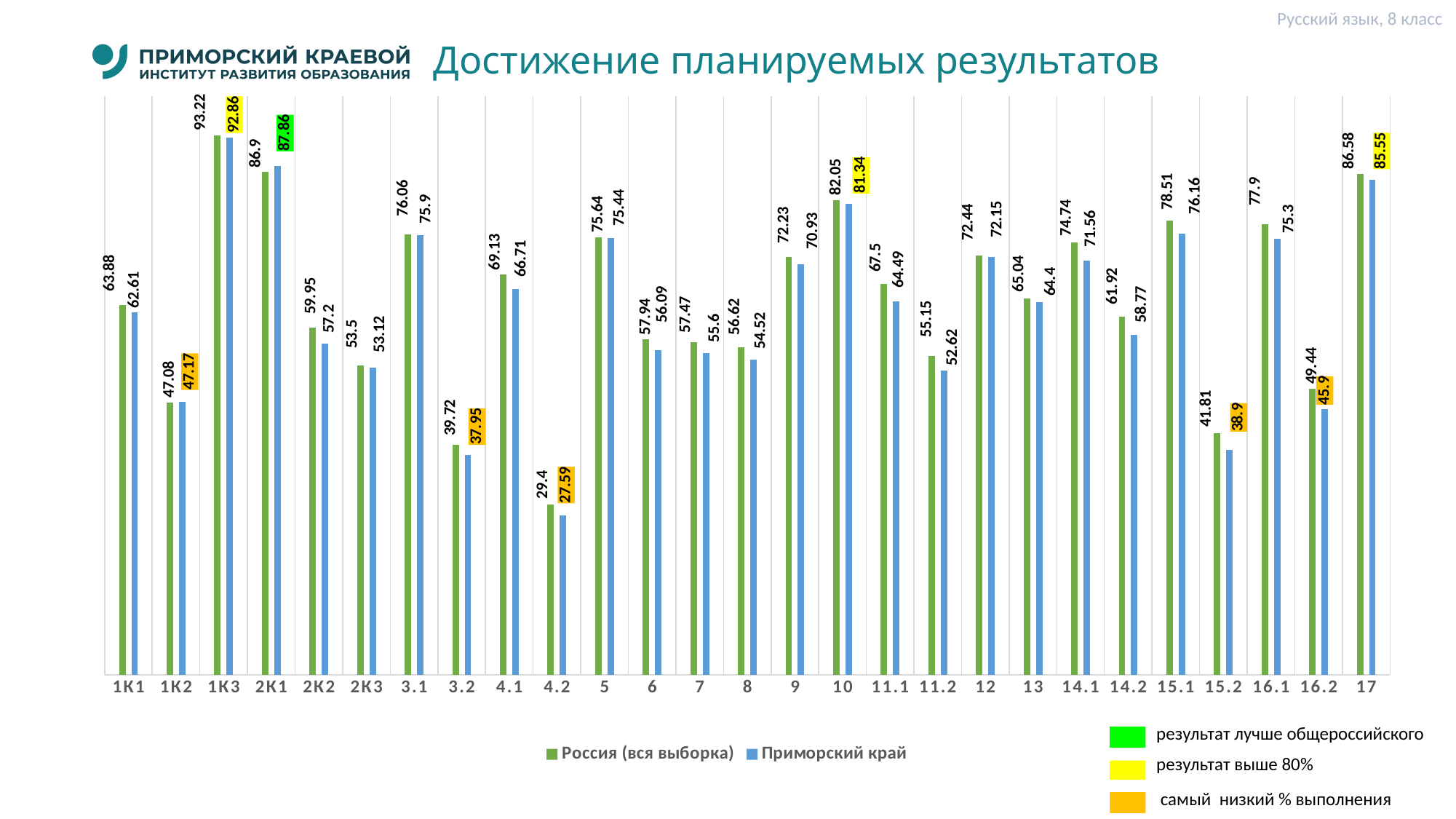
Which category has the lowest value for Россия (вся выборка)? 4.2 What type of chart is shown on the slide? bar chart What is the value for Россия (вся выборка) in category 4.2? 29.4 What is the difference between the Россия (вся выборка) and Приморский край values in category 1К1? 1.27 How many categories are shown on the x axis of the chart? 27 What is the value for Приморский край in category 15.2? 38.9 Which category has the highest value for Приморский край? 1К3 How many series does the chart legend list? 2 What is the difference between the Приморский край and Россия (вся выборка) values in category 17? 1.03 What is the value for Приморский край in category 1К3? 92.86 What is the title of the chart on the slide? Достижение планируемых результатов In category 2К1, which series has the larger value: Россия (вся выборка) or Приморский край? Приморский край